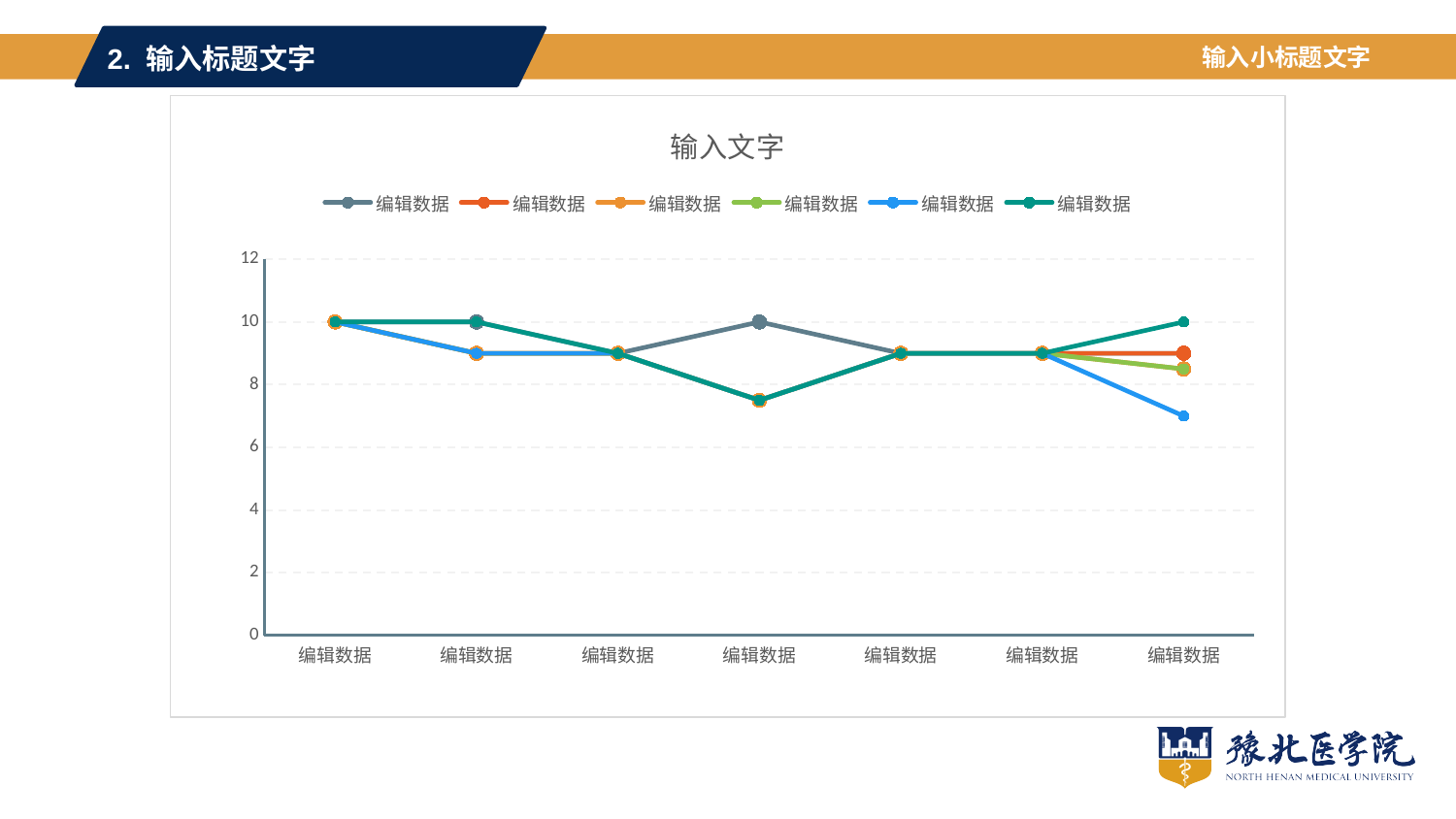
Is the value of the dark green line at the fourth category from the left greater or less than 8? less What is the highest value shown on the y axis? 12 How many series does the legend list? 6 What is the value of the grey line at the fourth category from the left? 10 Is the value of the blue line at the last (rightmost) category greater or less than 8? less At the last (rightmost) category, which is higher: the dark green line or the blue line? the dark green line How many categories are shown along the x axis? 7 Is the value of the blue line at the second category from the left greater or less than 8? greater What is the title of the chart? 输入文字 At the last (rightmost) category, which line has the lowest value? the blue line What is the value of the dark green line at the last (rightmost) category? 10 What kind of chart is shown on the slide? line chart